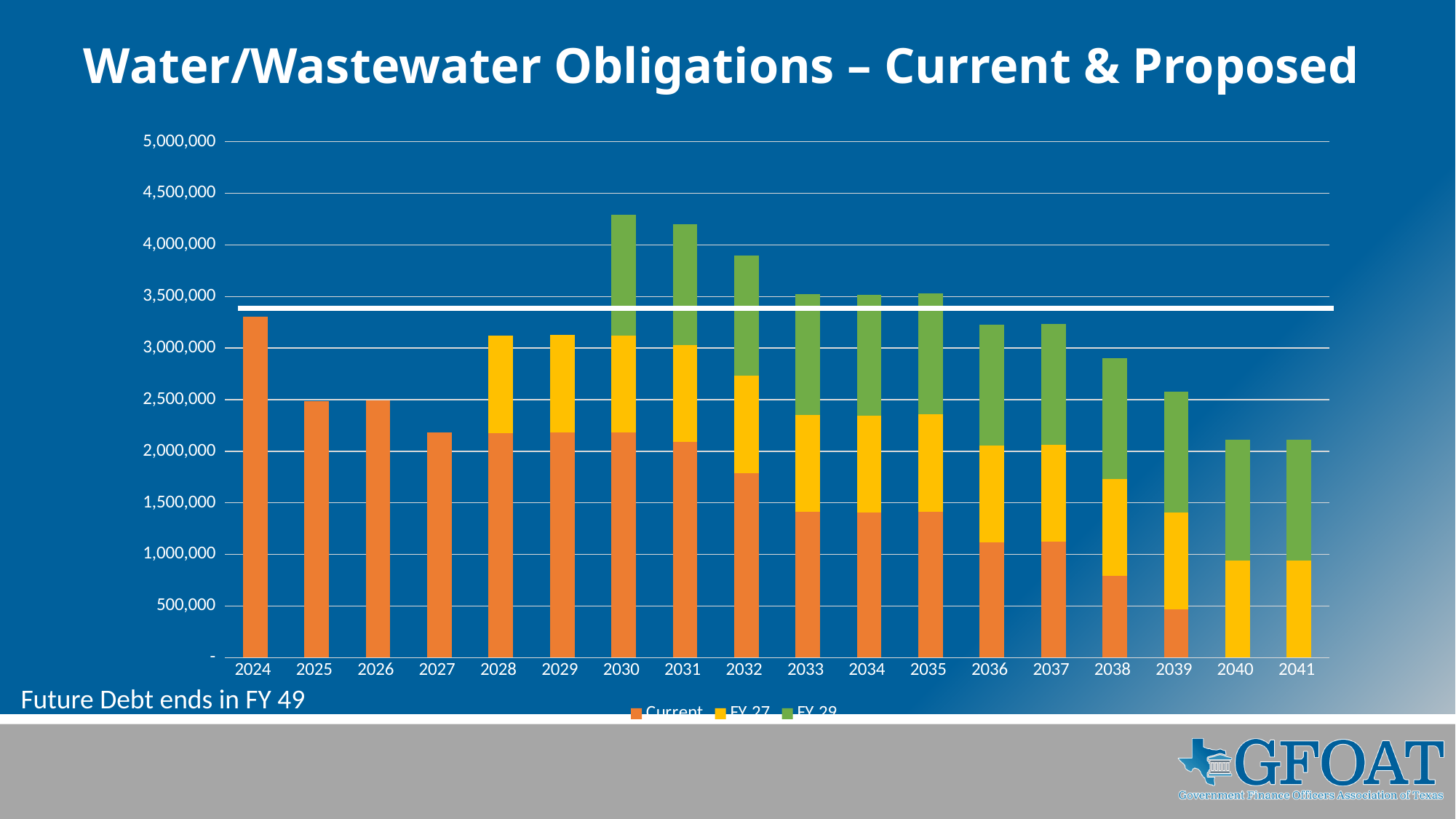
What kind of chart is shown on the slide? Stacked bar chart In which year does the FY 29 series first appear in the chart? 2030 Which year has the tallest total bar in the chart? 2030 How many years are shown along the x axis of the chart? 18 Which year has the larger total bar, 2032 or 2033? 2032 Do the total bar heights rise or fall from 2035 to 2041? fall Is the total for 2024 greater or less than 3,000,000? greater Is the total for 2030 greater or less than 4,000,000? greater Is the total for 2027 greater or less than 2,500,000? less What are the three series listed in the chart's legend? Current, FY 27, FY 29 How many series does the chart's legend list? 3